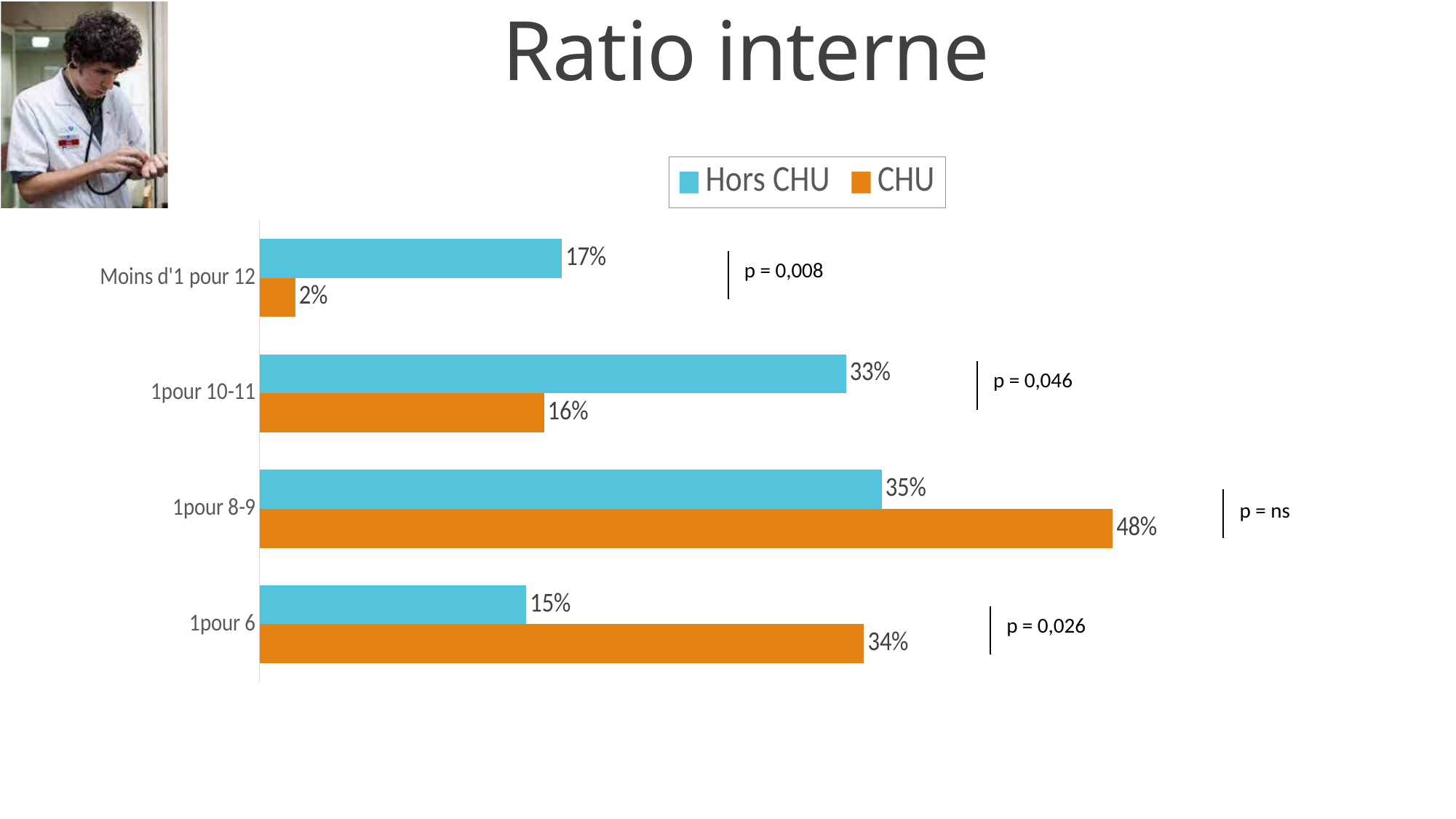
What is the CHU value for 'Moins d'1 pour 12'? 2% What is the Hors CHU value for '1pour 6'? 15% For '1pour 10-11', which series has the larger value, Hors CHU or CHU? Hors CHU What is the Hors CHU value for '1pour 10-11'? 33% How many series does the legend list? 2 What is the CHU value for '1pour 8-9'? 48% Which category has the highest CHU value? 1pour 8-9 Which category has the lowest Hors CHU value? 1pour 6 What is the difference between the CHU and Hors CHU values for '1pour 6'? 19% What kind of chart is shown on the slide? Bar chart How many categories are shown on the chart? 4 What is the title of the slide? Ratio interne